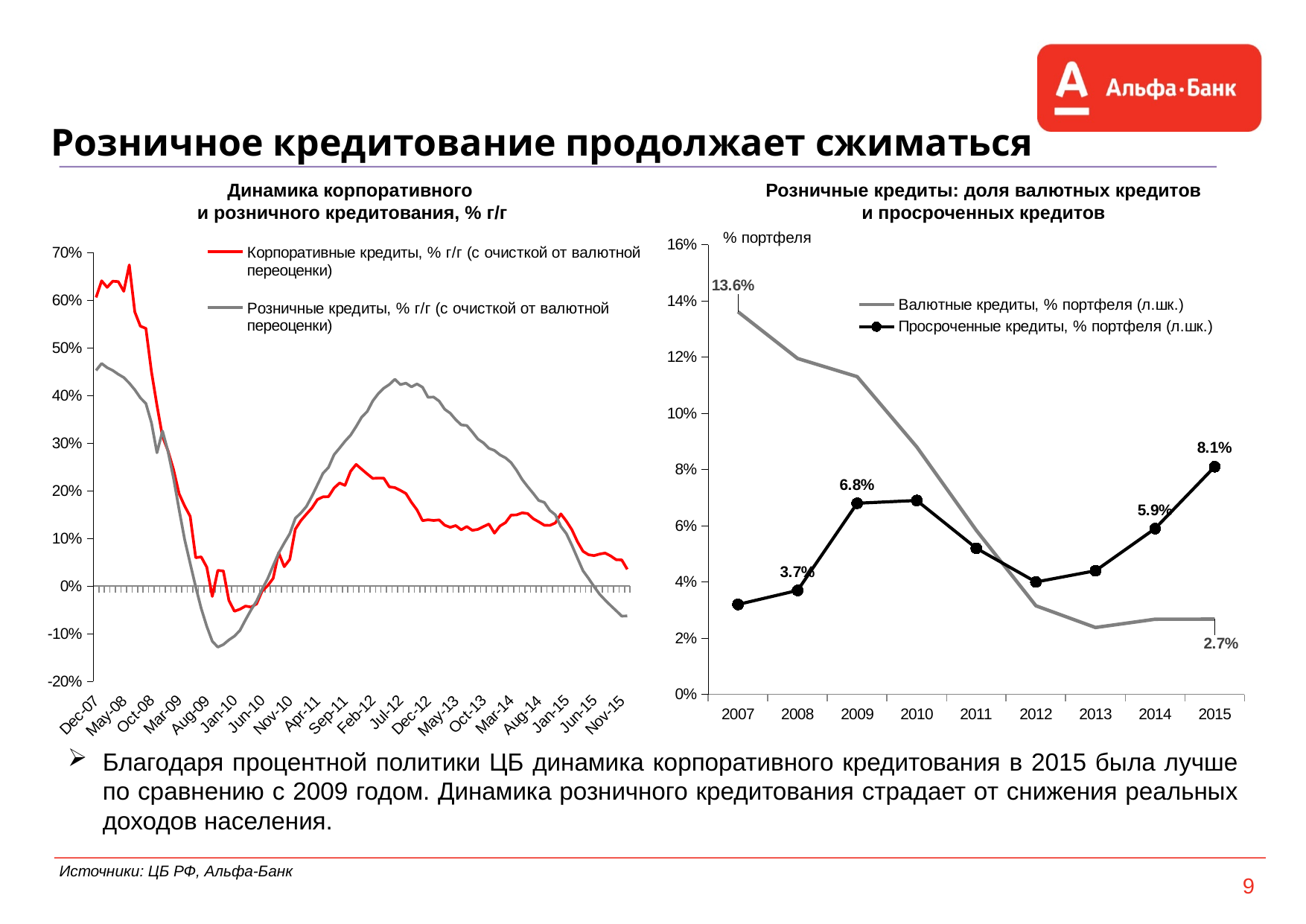
On the right chart, how many years are shown on the x axis? 9 On the right chart, is the value of Валютные кредиты in 2012 greater or less than 4%? less What kind of chart is the left chart (Динамика корпоративного и розничного кредитования, % г/г)? line chart On the left chart, is the peak value of Розничные кредиты around Jul-12 greater or less than 40%? greater On the right chart, does Валютные кредиты rise or fall from 2007 to 2015? fall On the right chart, what is the value of Просроченные кредиты in 2009? 6.8% On the right chart, what is the value of Просроченные кредиты in 2015? 8.1% On the right chart, what is the value of Валютные кредиты in 2015? 2.7% On the right chart (Розничные кредиты: доля валютных кредитов и просроченных кредитов), what is the value of Валютные кредиты in 2007? 13.6% On the left chart (Динамика корпоративного и розничного кредитования, % г/г), how many series does the legend list? 2 On the right chart, in which year is Просроченные кредиты highest? 2015 On the right chart, by how many percentage points did Просроченные кредиты increase from 2014 to 2015? 2.2 percentage points